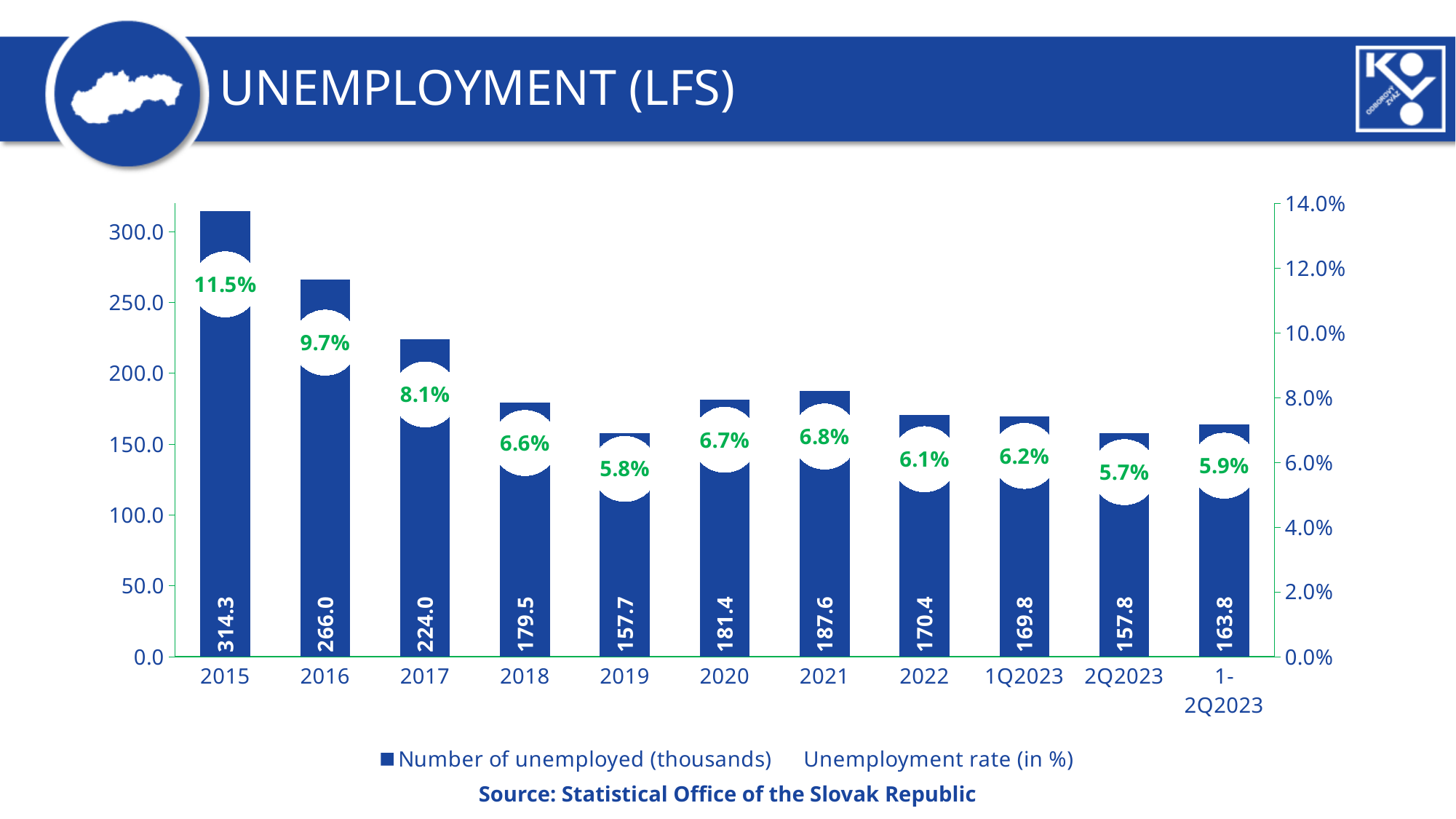
How many categories are shown on the x axis? 11 Which category has the highest number of unemployed (thousands)? 2015 Does the unemployment rate (in %) rise or fall from 2015 to 2019? fall What is the number of unemployed (thousands) for 2015? 314.3 Which category has the lowest unemployment rate (in %)? 2Q2023 What is the number of unemployed (thousands) for 2Q2023? 157.8 Is the number of unemployed (thousands) for 2017 greater or less than 200.0? greater What kind of chart is used for the number of unemployed (thousands) series? bar chart Which has a higher number of unemployed (thousands), 2020 or 2021? 2021 How many series does the legend list? 2 What is the unemployment rate (in %) for 2019? 5.8% What is the difference in the number of unemployed (thousands) between 2015 and 2016? 48.3